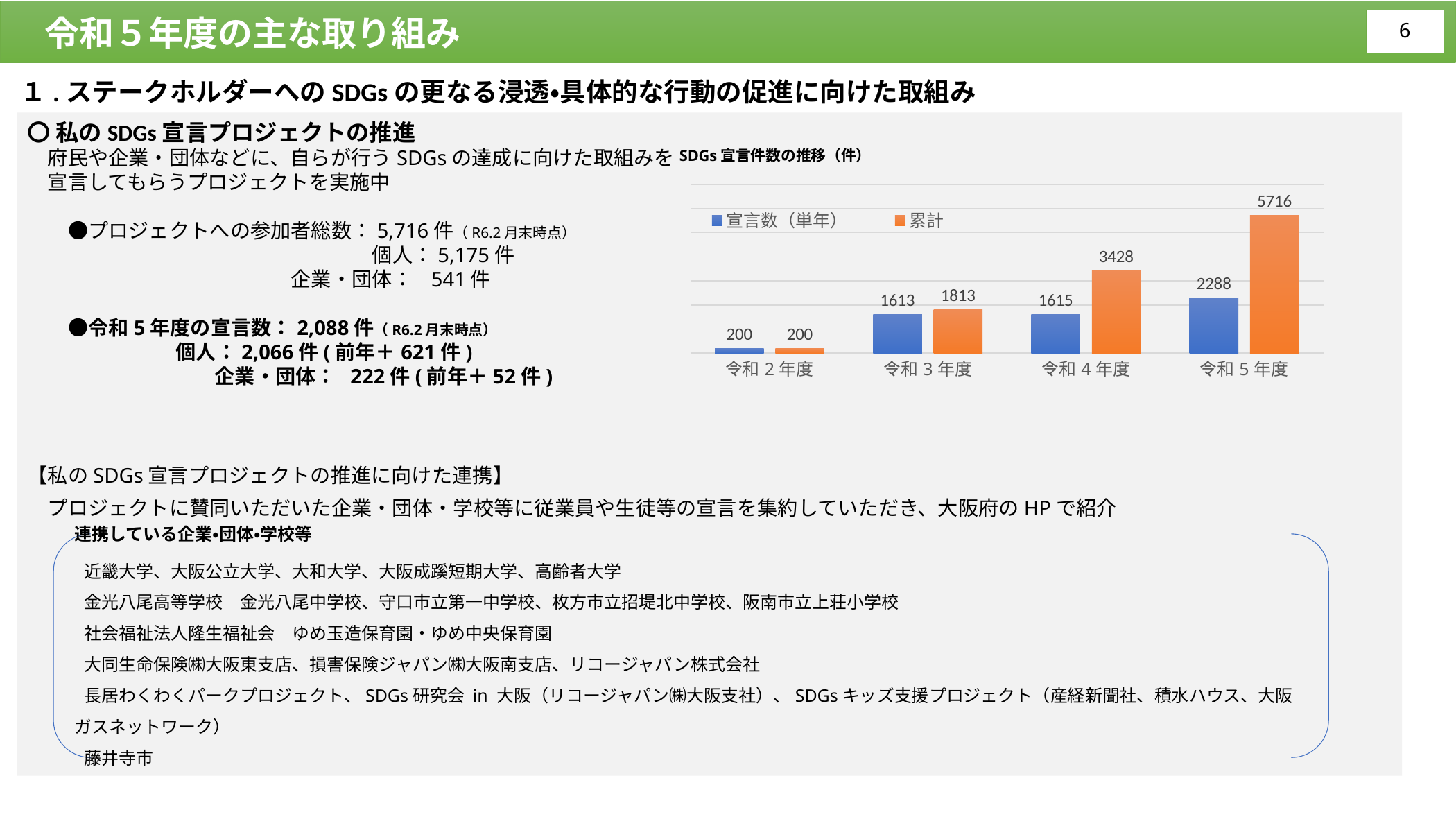
Does the 累計 series rise or fall from 令和２年度 to 令和５年度? Rises How many fiscal years are shown on the x axis of the chart? 4 What is the value of 累計 for 令和３年度? 1813 What is the value of 宣言数（単年） for 令和５年度? 2288 Which is larger: the 累計 value for 令和３年度 or the 宣言数（単年） value for 令和５年度? 宣言数（単年） for 令和５年度 What kind of chart is shown on the slide? Bar chart Which fiscal year has the highest 累計 value? 令和５年度 What is the difference between the 累計 values for 令和５年度 and 令和４年度? 2288 What is the value of 累計 for 令和４年度? 3428 How many series does the chart legend list? 2 Which fiscal year has the lowest 宣言数（単年） value? 令和２年度 What is the difference between the 宣言数（単年） values for 令和５年度 and 令和３年度? 675